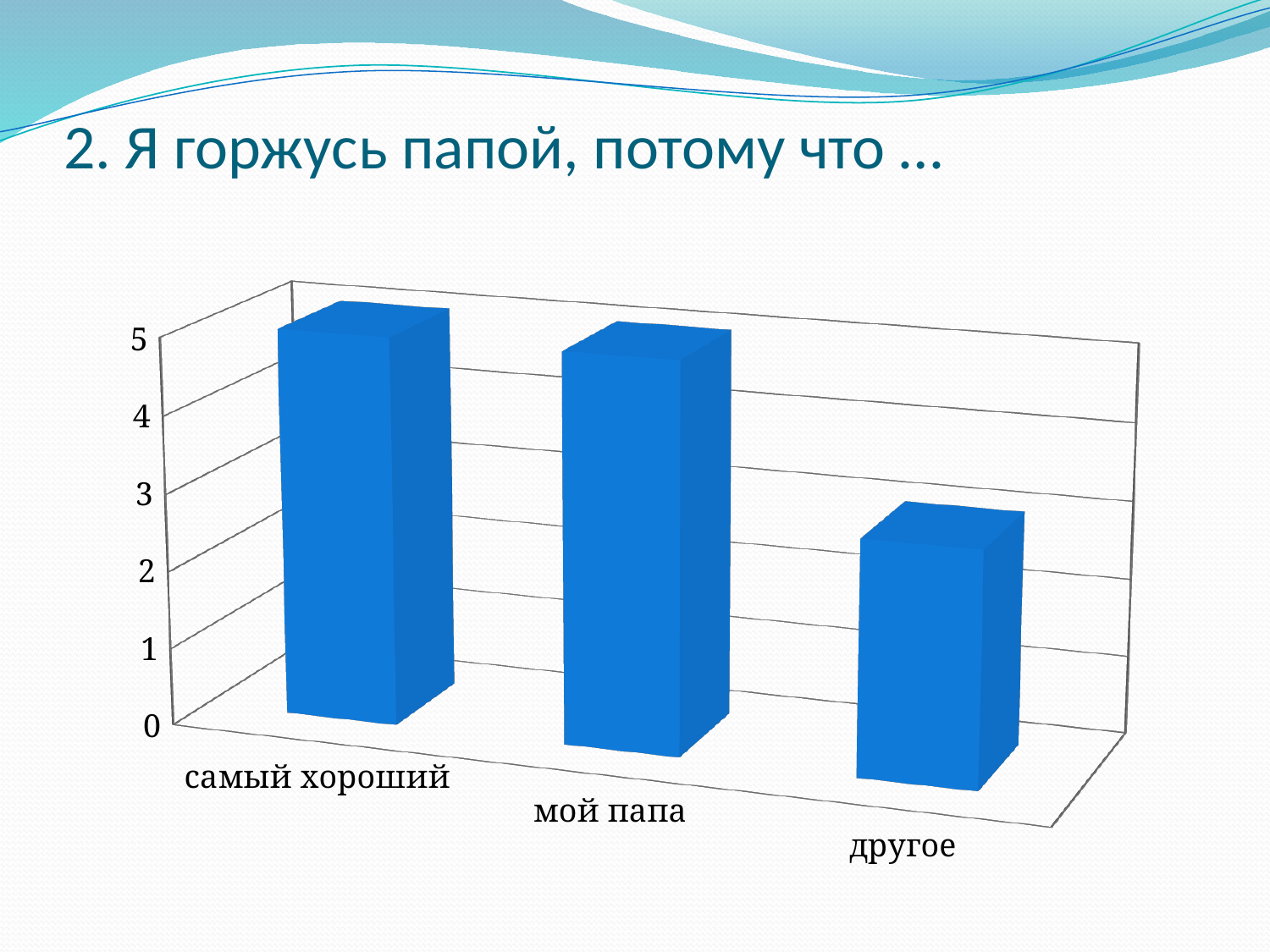
Which category has the lowest bar in the chart? другое Which is larger, the value for "мой папа" or the value for "другое"? мой папа What is the title of the slide containing the chart? 2. Я горжусь папой, потому что … What kind of chart is shown on the slide? bar chart Is the value for "другое" greater or less than 4? less Is the value for "другое" greater or less than 1? greater Is the value for "самый хороший" greater or less than 3? greater Which is larger, the value for "самый хороший" or the value for "другое"? самый хороший How many categories are shown on the x axis of the chart? 3 What is the highest value shown on the vertical axis of the chart? 5